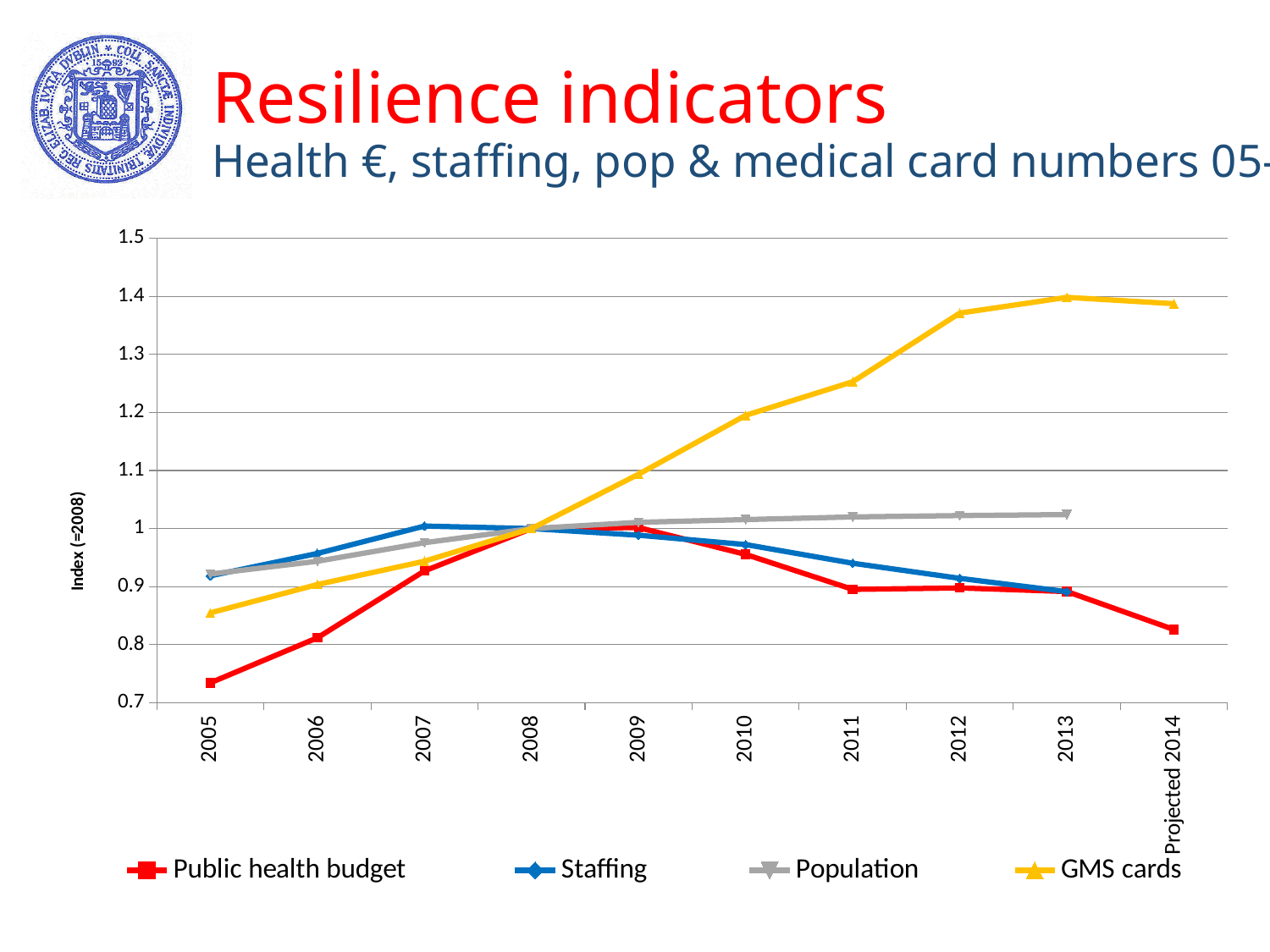
Is the value for GMS cards in 2013 greater or less than 1.3? greater How many points are there along the x axis? 10 Does the GMS cards series rise or fall from 2005 to 2013? rise Is the value for Public health budget in 2005 greater or less than 0.8? less What is the label on the y axis? Index (=2008) Which series has the lowest value in 2005? Public health budget Which series has the highest value in 2013? GMS cards Is the value for Public health budget in Projected 2014 greater or less than 0.9? less What kind of chart is shown on the slide? line chart What is the value of every series in 2008? 1 In 2011, which is larger: Staffing or Public health budget? Staffing How many series does the legend list? 4